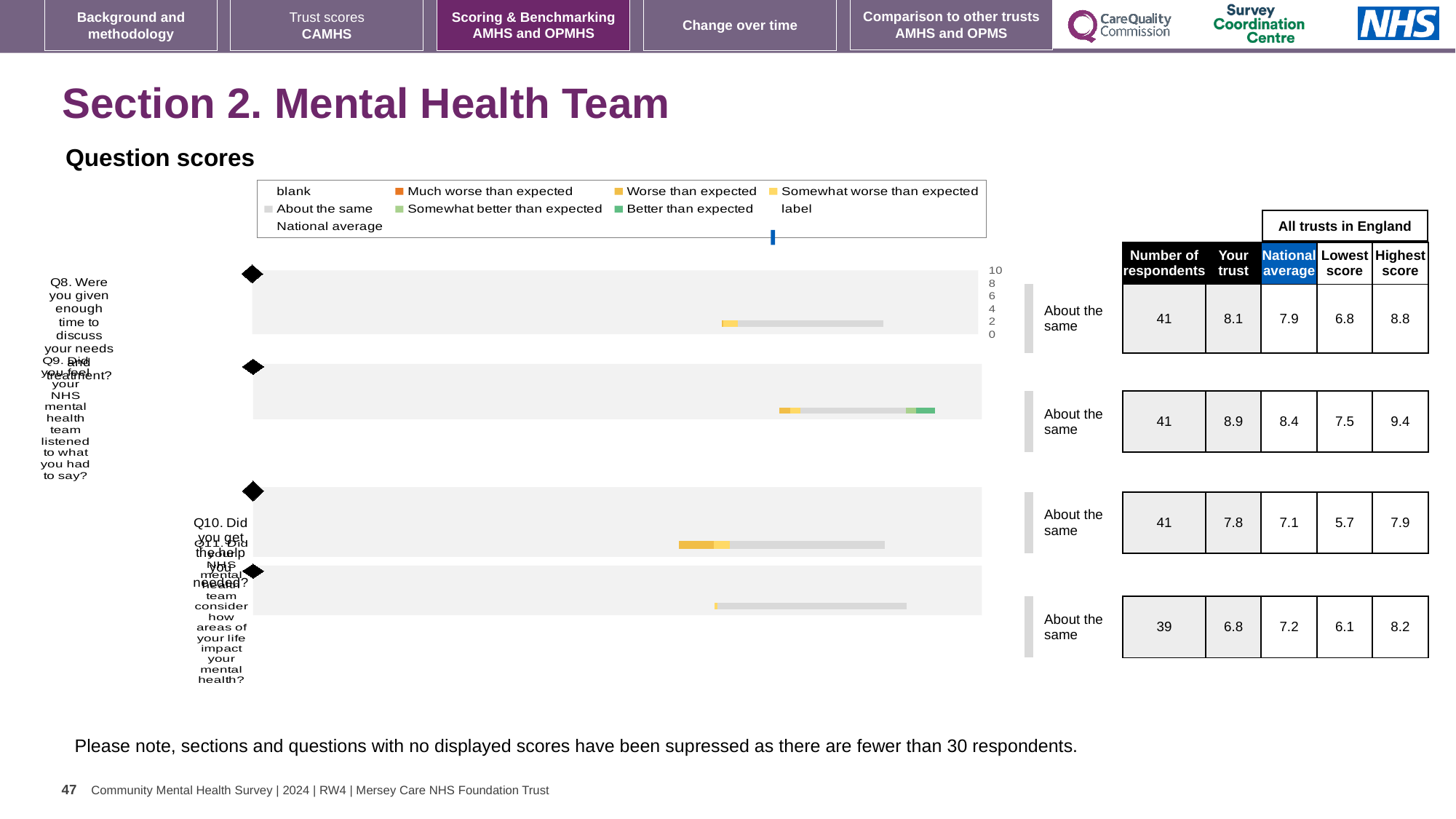
Which question has the highest 'Your trust' score in the table beside the chart? Q9 In the table beside the chart, what is the highest score among all trusts in England for Q10? 7.9 In the table beside the chart, what is the national average for Q9? 8.4 What is the difference between the 'Your trust' score and the national average for Q9? 0.5 In the table beside the chart, what is the 'Your trust' score for Q8? 8.1 Which question has the lowest 'Your trust' score in the table beside the chart? Q11 In the table beside the chart, how many respondents are recorded for Q11? 39 What benchmark label is shown next to each of the four question bars in the chart? About the same How many entries does the legend of the question scores chart list? 9 What kind of chart is used to show the question scores on this slide? bar chart For Q11, which is larger: the 'Your trust' score or the national average? National average How many questions (Q8 to Q11) are plotted in the question scores chart? 4